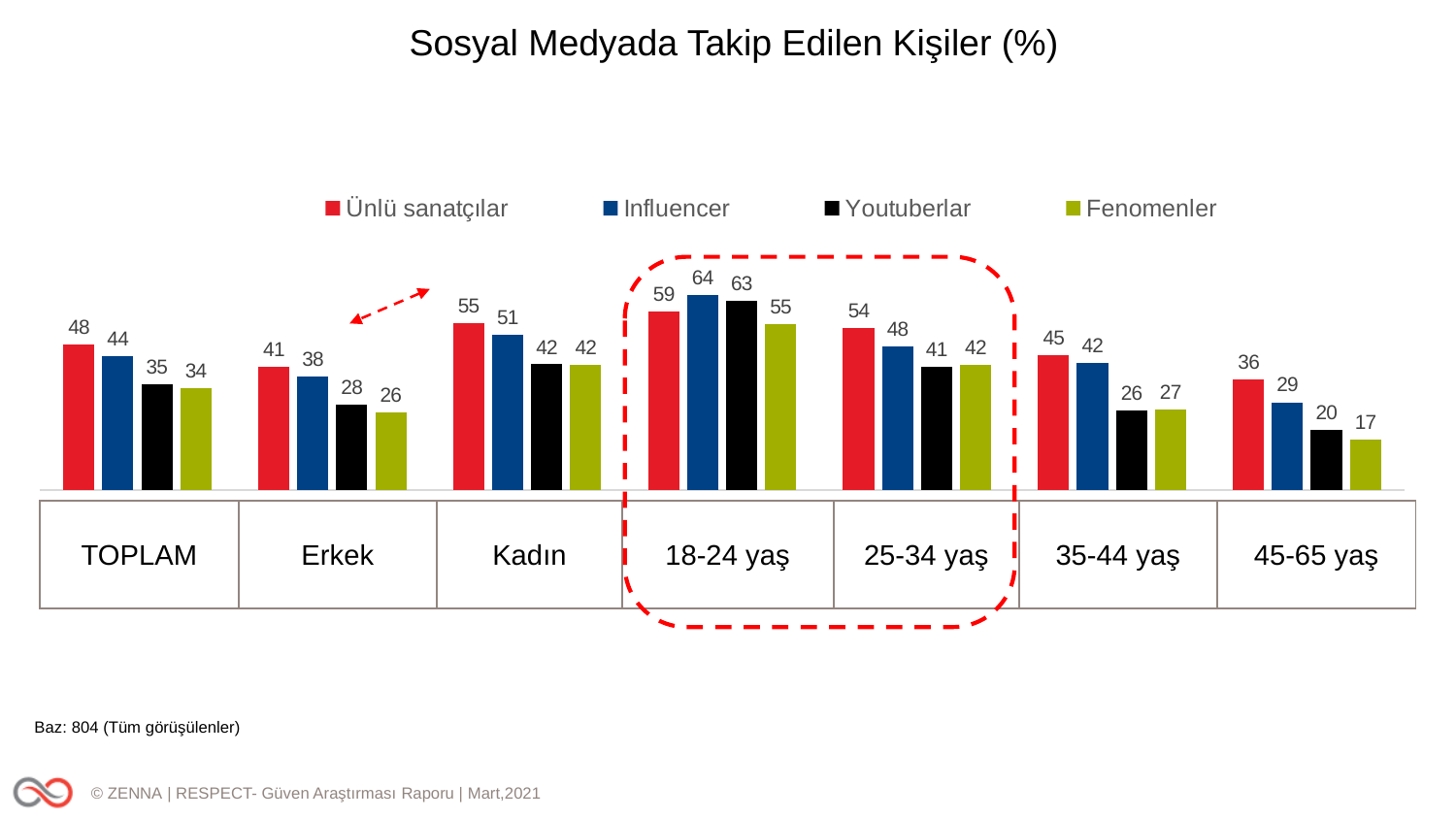
What is the value for Ünlü sanatçılar in the TOPLAM category? 48 How many series does the legend list? 4 Which is larger in the 25-34 yaş category: Ünlü sanatçılar or Influencer? Ünlü sanatçılar What is the value for Influencer in the 18-24 yaş category? 64 Which category has the highest value for Influencer? 18-24 yaş What kind of chart is shown on the slide? Bar chart How many categories are shown on the x axis? 7 Which category has the lowest value for Youtuberlar? 45-65 yaş Do the Youtuberlar values rise or fall across the age groups from 18-24 yaş to 45-65 yaş? Fall What is the value for Fenomenler in the 45-65 yaş category? 17 What is the difference between the Ünlü sanatçılar values for Kadın and Erkek? 14 What is the value for Youtuberlar in the Kadın category? 42